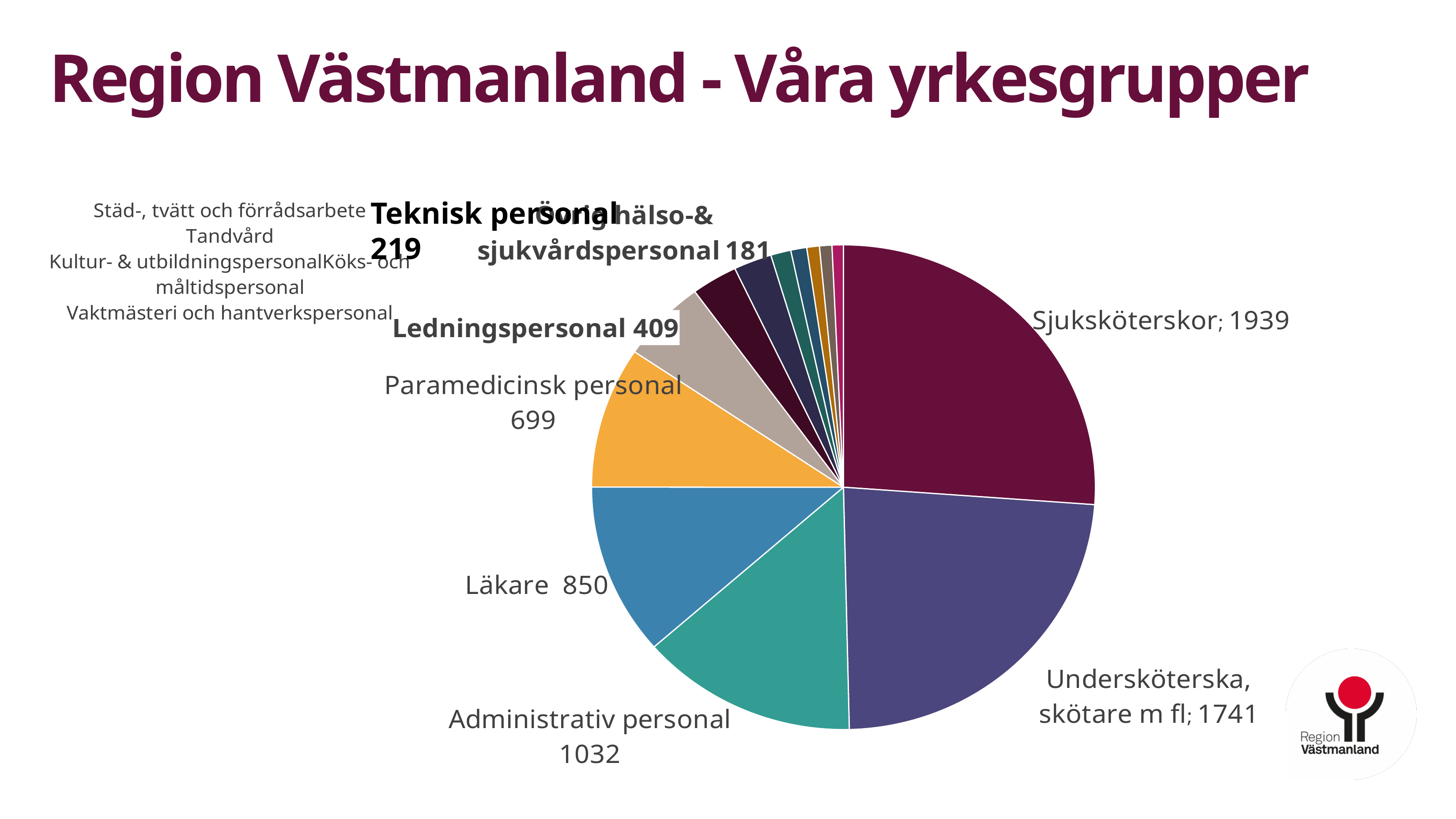
What is the value for Administrativ personal? 1032 What is the value for Sjuksköterskor? 1939 What type of chart is shown on the slide? pie chart What is the value for Läkare? 850 What is the value for Undersköterska, skötare m fl? 1741 What is the value for Teknisk personal? 219 Which is larger, the value for Administrativ personal or the value for Läkare? Administrativ personal What is the difference between the values for Sjuksköterskor and Undersköterska, skötare m fl? 198 What is the title of the slide containing the chart? Region Västmanland - Våra yrkesgrupper What is the value for Ledningspersonal? 409 Which category has the largest slice of the pie? Sjuksköterskor What is the value for Paramedicinsk personal? 699